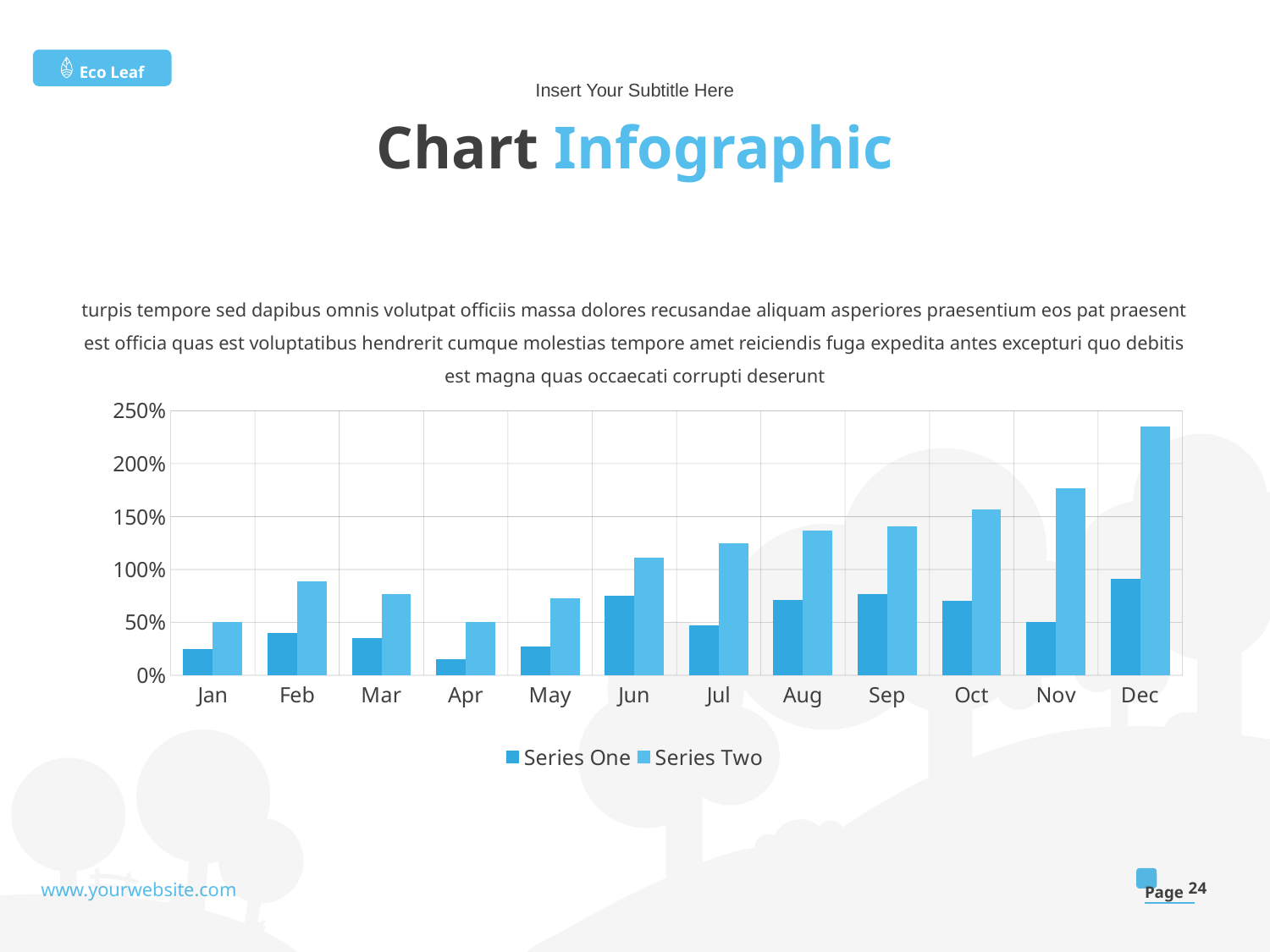
In which month is the Series One value highest? Dec Do the Series Two values generally rise or fall from Jan to Dec? rise Is the Series One value for Apr greater or less than 50%? less In which month is the Series Two value highest? Dec What kind of chart is shown on the slide? bar chart Is the Series Two value for Oct greater or less than 150%? greater What are the names of the series listed in the chart's legend? Series One and Series Two How many series does the chart's legend list? 2 How many categories are shown along the x axis of the chart? 12 Is the Series Two value for Dec greater or less than 200%? greater Which is larger in Aug, the Series One value or the Series Two value? Series Two In which month is the Series One value lowest? Apr